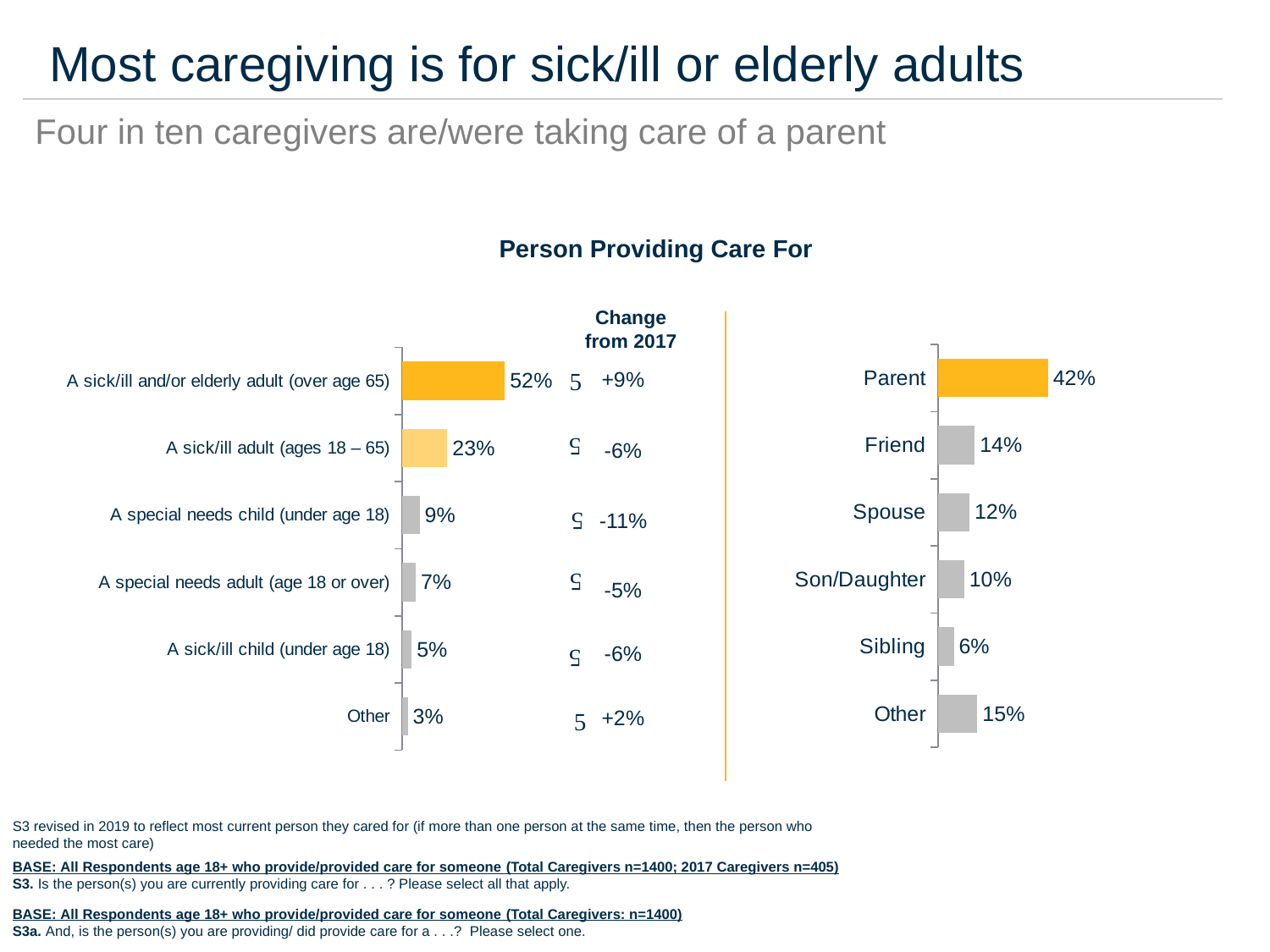
In the right chart, what is the difference between the values for Parent and Friend? 28% In the right chart, what is the value for Spouse? 12% In the left chart, which category has the lowest value? Other In the left chart, what is the value for 'A special needs child (under age 18)'? 9% In the right chart, which category has the highest value? Parent In the left chart, what is the difference between the values for 'A sick/ill and/or elderly adult (over age 65)' and 'A sick/ill adult (ages 18 – 65)'? 29% In the right chart, which is larger, the value for Other or the value for Son/Daughter? Other In the right chart, which category has the lowest value? Sibling What kind of chart is the left chart? Bar chart In the left chart, what is the value for 'A sick/ill and/or elderly adult (over age 65)'? 52% How many categories are shown in the right chart? 6 In the left chart, what is the 'Change from 2017' shown for 'A special needs child (under age 18)'? -11%